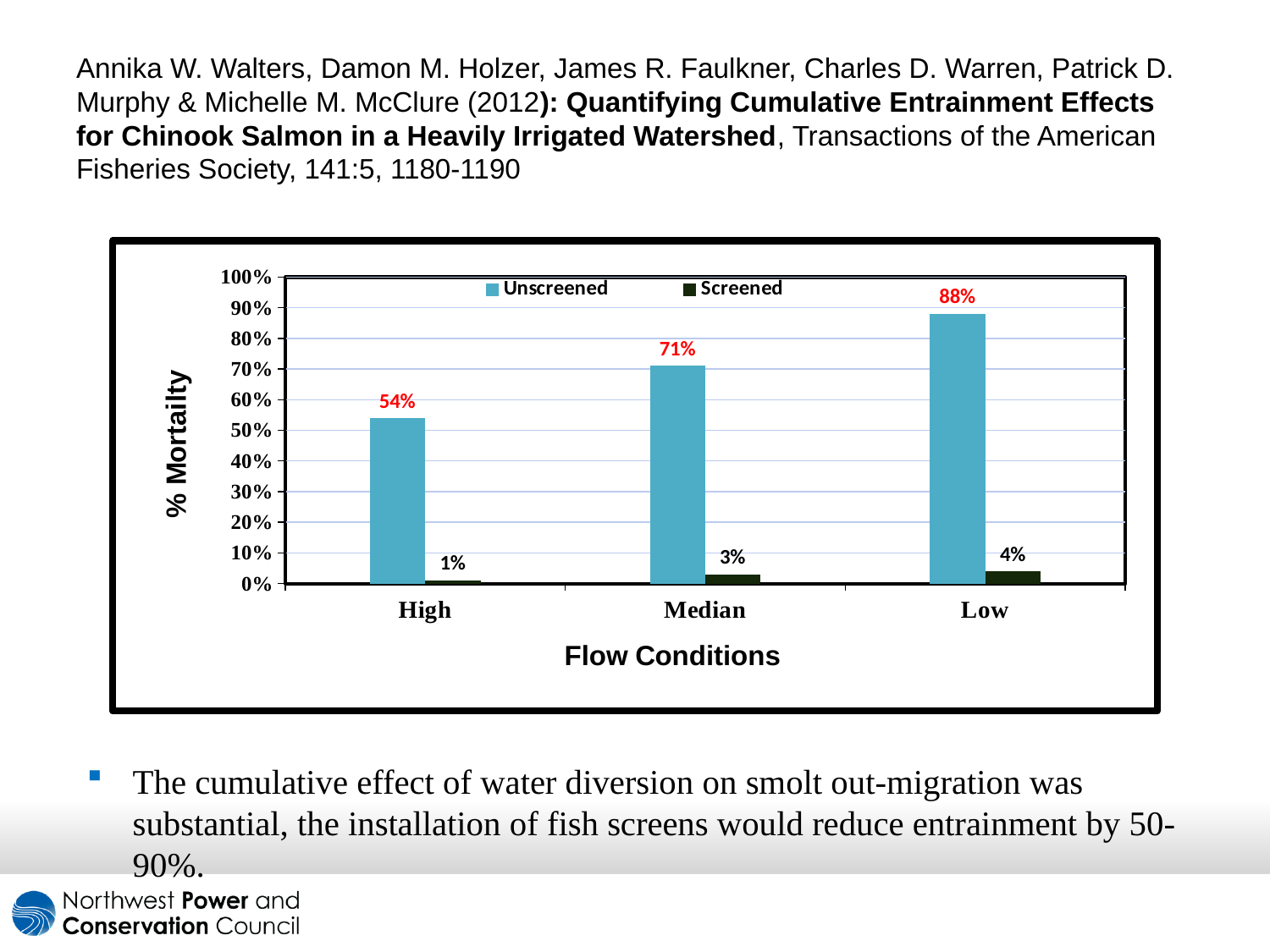
Which flow condition has the highest Unscreened % Mortality? Low How many flow condition categories are shown on the x axis? 3 What kind of chart is shown on the slide? Bar chart What is the % Mortality for Unscreened under High flow conditions? 54% How many series does the legend list? 2 What is the difference in Unscreened % Mortality between Low and High flow conditions? 34% What is the difference between the Unscreened and Screened % Mortality under Low flow conditions? 84% Does the Unscreened % Mortality rise or fall from High to Low flow conditions? Rise Which is larger: the Screened % Mortality under Median flow or under High flow? Median What is the % Mortality for Unscreened under Median flow conditions? 71% Which flow condition has the lowest Screened % Mortality? High What is the % Mortality for Screened under Low flow conditions? 4%